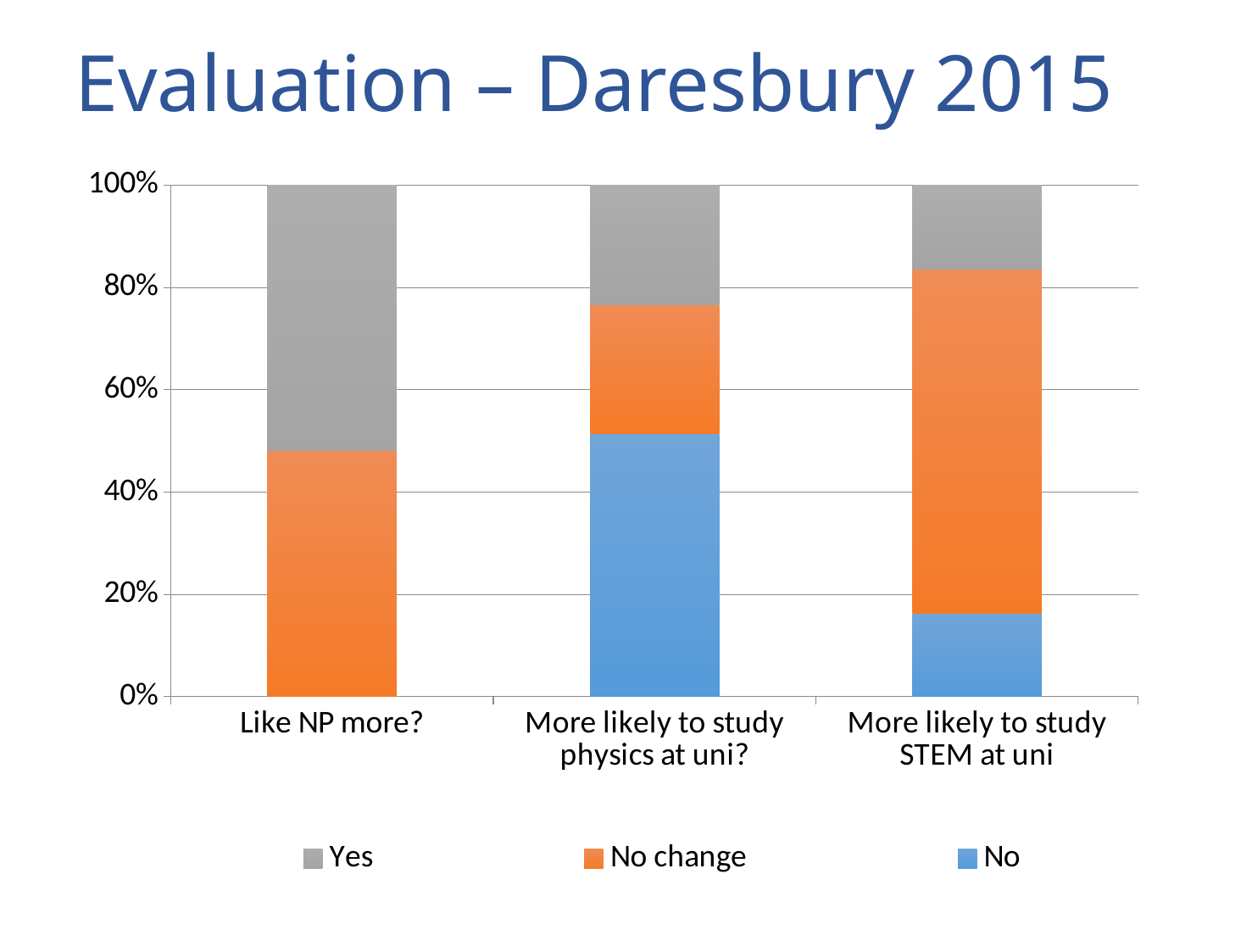
How many series does the legend list? 3 Which is larger: the 'Yes' share for 'Like NP more?' or the 'Yes' share for 'More likely to study STEM at uni'? Like NP more? Which category has the largest 'Yes' share? Like NP more? What kind of chart is shown on the slide? Stacked bar chart Is the 'No change' share for 'More likely to study STEM at uni' greater or less than 60%? greater Is the 'No' share for 'More likely to study STEM at uni' greater or less than 20%? less Is the 'No' share for 'More likely to study physics at uni?' greater or less than 40%? greater What is the total height of the stacked bar for 'Like NP more?'? 100% Which category has the largest 'No' share? More likely to study physics at uni? What is the title of the slide containing the chart? Evaluation – Daresbury 2015 How many categories are shown on the x axis? 3 What are the three series listed in the legend? Yes, No change, No